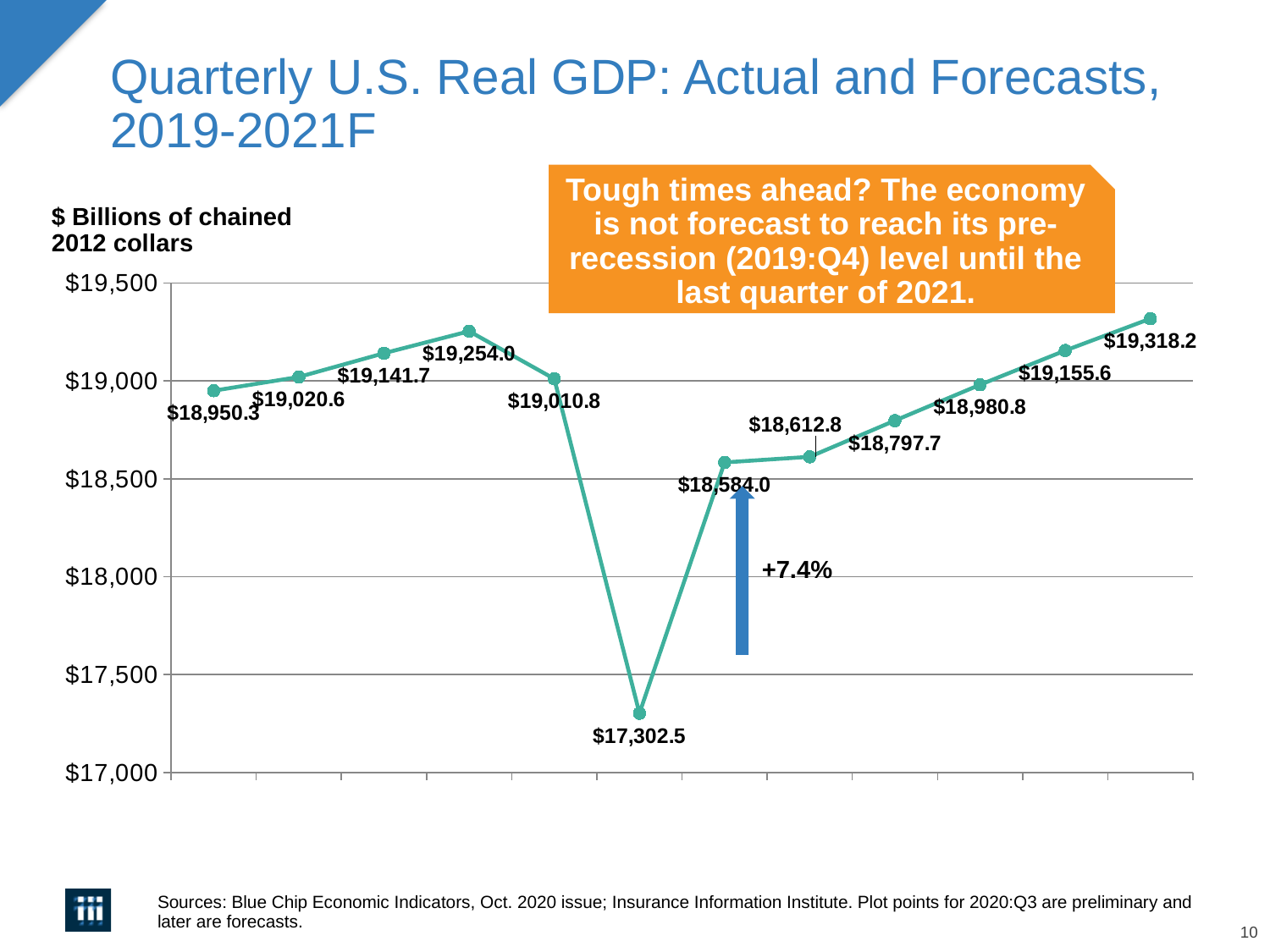
What is the value of the last data point on the chart? $19,318.2 Is the lowest point on the chart greater or less than $17,500? less Which is larger: the pre-drop peak of $19,254.0 or the final point of $19,318.2? $19,318.2 How many data points are plotted on the line? 12 What is the difference between the last data point ($19,318.2) and the first data point ($18,950.3)? $367.9 What is the highest value plotted on the chart? $19,318.2 What is the lowest value plotted on the chart? $17,302.5 What is the value of the data point immediately before the sharp drop to $17,302.5? $19,010.8 What is the difference between the pre-drop peak of $19,254.0 and the trough of $17,302.5? $1,951.5 What is the value of the first data point on the chart? $18,950.3 What percentage change is labeled next to the blue arrow on the chart? +7.4% What kind of chart is shown on the slide? line chart